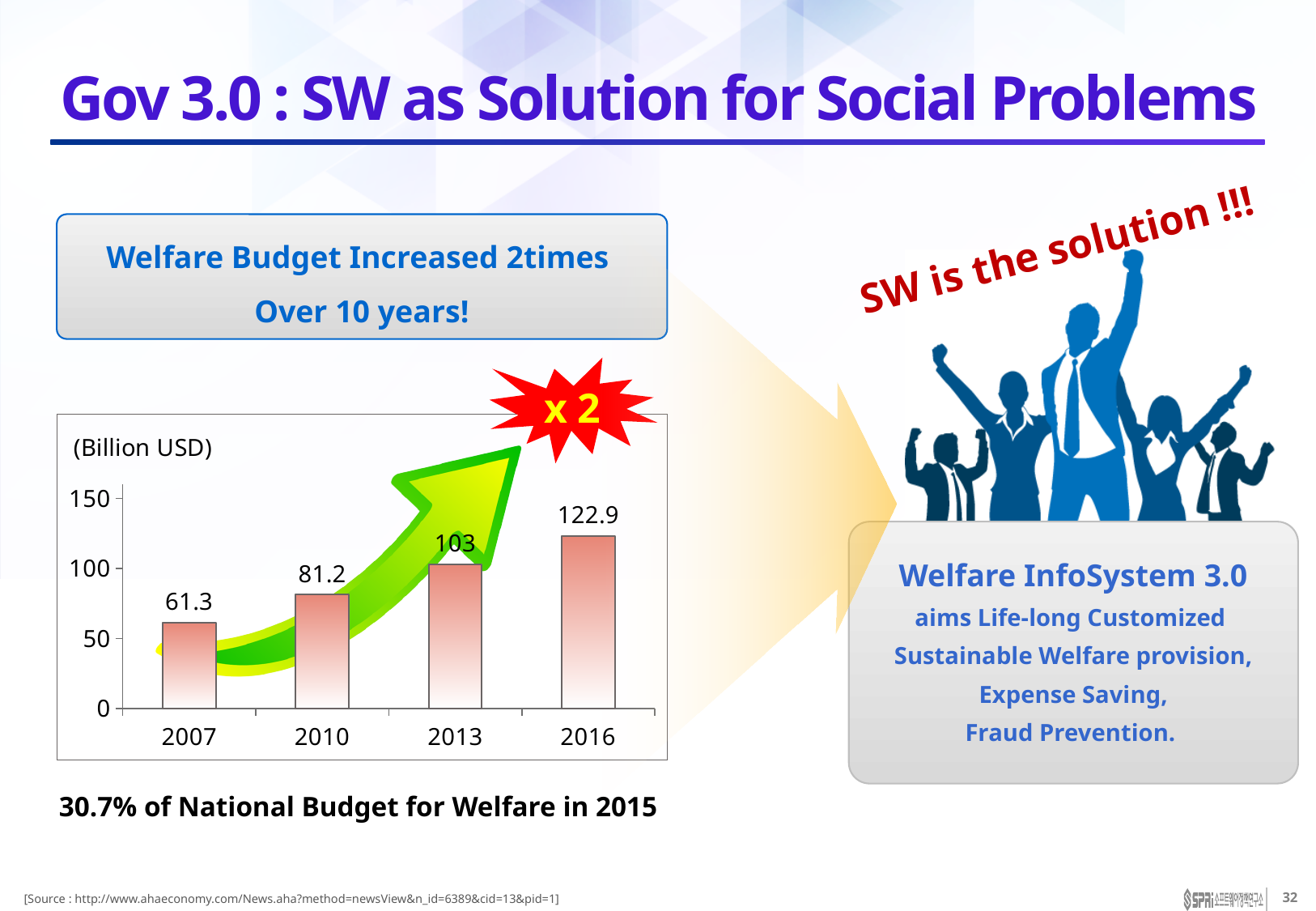
How many years are shown on the x axis of the chart? 4 Which year has the highest welfare budget value? 2016 What is the welfare budget value for 2013? 103 What is the welfare budget value for 2010? 81.2 Is the value for 2013 greater or less than 100? greater What kind of chart is shown on the slide? bar chart What is the welfare budget value for 2007? 61.3 What is the welfare budget value for 2016? 122.9 Do the values rise or fall from 2007 to 2016? rise Which is larger, the value for 2010 or the value for 2013? 2013 Which year has the lowest welfare budget value? 2007 What is the difference between the 2016 and 2007 values? 61.6